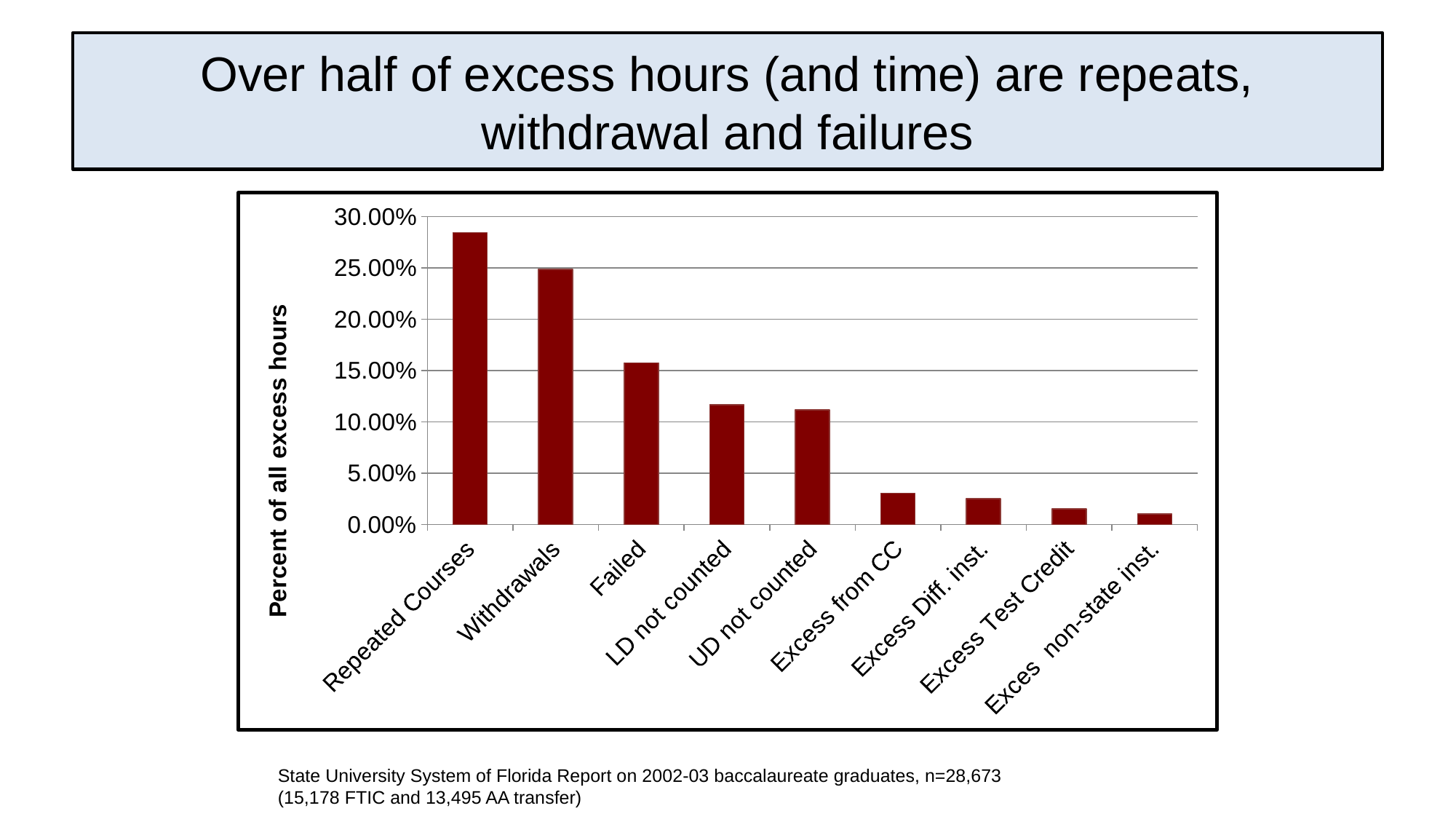
Which category has the highest percent of all excess hours? Repeated Courses What kind of chart is shown on the slide? bar chart What is the title of the vertical axis? Percent of all excess hours Is the value for Repeated Courses greater or less than 25.00%? greater Which category has the lowest percent of all excess hours? Exces non-state inst. Is the value for LD not counted greater or less than 10.00%? greater Do the bar values rise or fall moving from left to right along the x axis? fall Is the value for Failed greater or less than 15.00%? greater Which is larger, the value for Withdrawals or the value for Failed? Withdrawals How many categories are plotted on the chart? 9